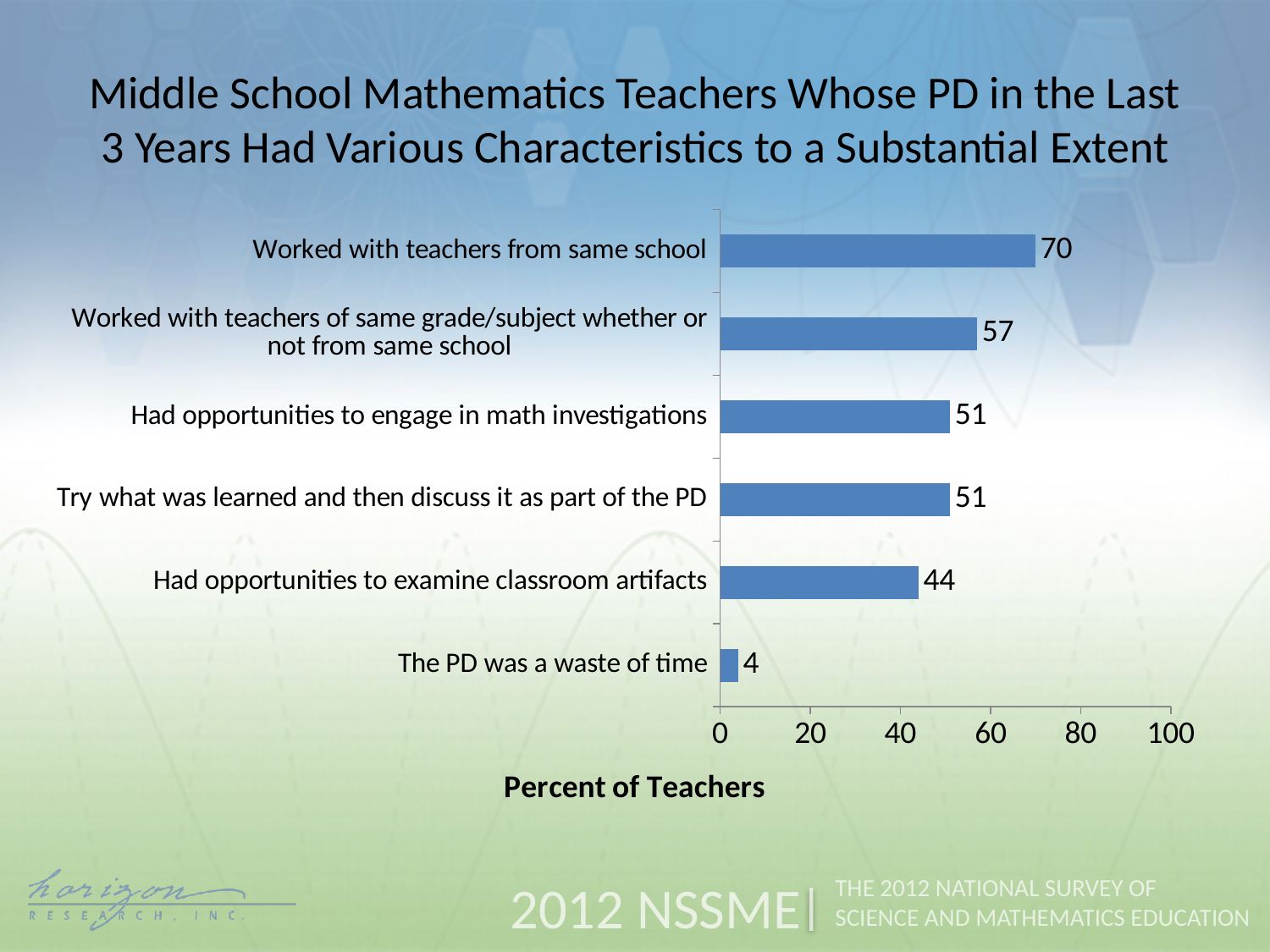
How many categories are shown in the chart? 6 Which category has the highest value? Worked with teachers from same school Is the value for 'Worked with teachers of same grade/subject whether or not from same school' greater or less than 60? less Which is larger: 'Had opportunities to examine classroom artifacts' or 'Had opportunities to engage in math investigations'? Had opportunities to engage in math investigations What is the label of the horizontal axis? Percent of Teachers What percent of teachers worked with teachers from the same school? 70 What is the difference between 'Try what was learned and then discuss it as part of the PD' and 'The PD was a waste of time'? 47 What is the value for 'The PD was a waste of time'? 4 What kind of chart is shown on the slide? Bar chart Which category has the lowest value? The PD was a waste of time What is the difference between 'Worked with teachers from same school' and 'Worked with teachers of same grade/subject whether or not from same school'? 13 What is the value for 'Had opportunities to examine classroom artifacts'? 44